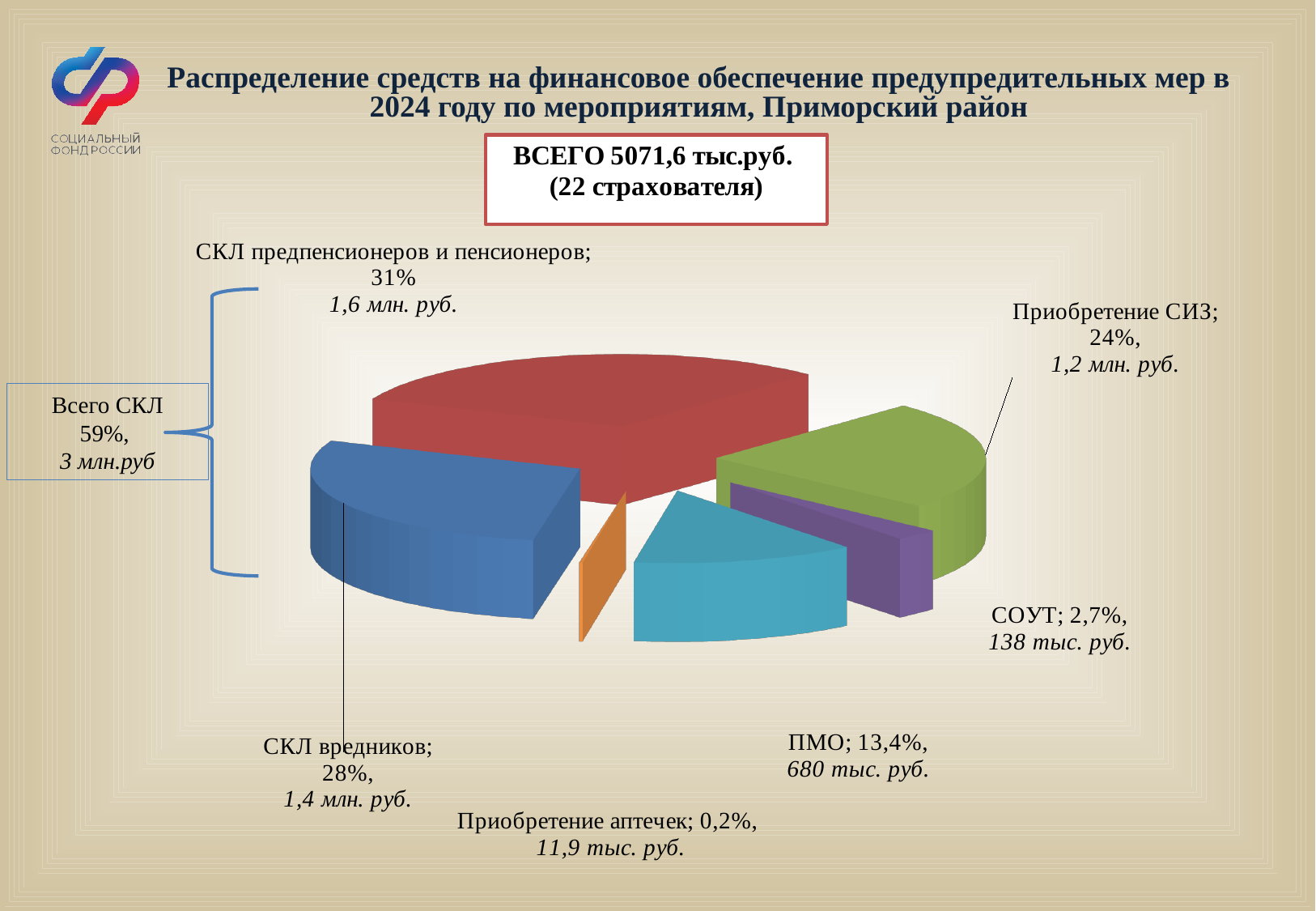
What is the difference in percentage points between the shares of "СКЛ предпенсионеров и пенсионеров" and "Приобретение СИЗ"? 7 What kind of chart is shown on the slide? pie chart Which category has the smallest share of the pie? Приобретение аптечек Which category has the largest share of the pie? СКЛ предпенсионеров и пенсионеров Which has a larger share: "СКЛ вредников" or "ПМО"? СКЛ вредников How many slices does the pie chart have? 6 What total amount is stated in the box above the chart? 5071,6 тыс.руб. What is the amount shown for "СОУТ"? 138 тыс. руб. What is the amount shown for "Приобретение аптечек"? 11,9 тыс. руб. What share of the pie does "Приобретение СИЗ" have? 24% What share of the pie does "СКЛ предпенсионеров и пенсионеров" have? 31% What is the amount shown for "ПМО"? 680 тыс. руб.